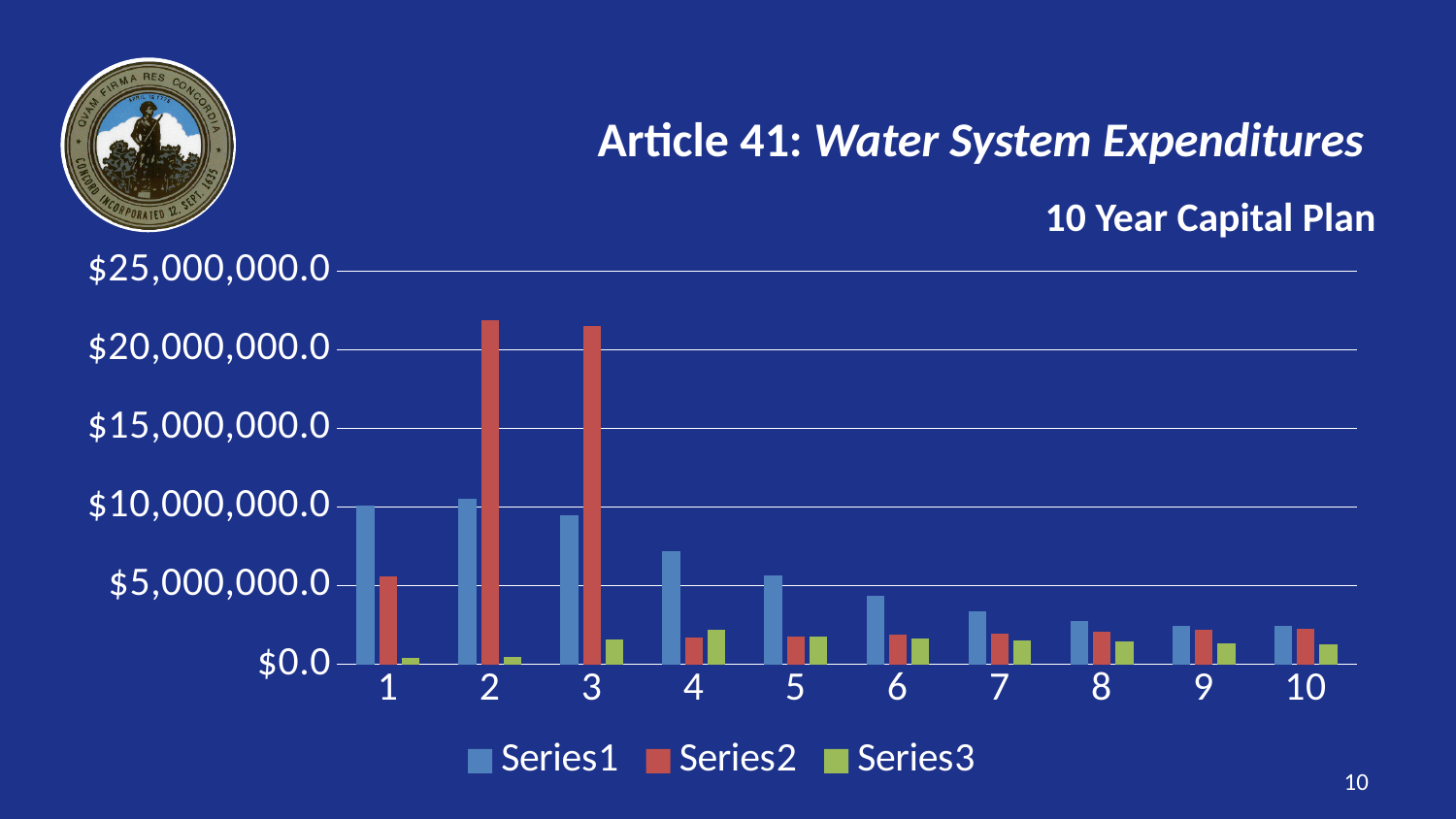
For category 2, which series has the larger value, Series1 or Series2? Series2 How many series does the legend list? 3 Is the Series2 value for category 2 greater or less than $20,000,000.0? greater What is the subtitle shown above the chart? 10 Year Capital Plan What kind of chart is shown on the slide? Bar chart Do the Series1 values generally rise or fall from category 1 to category 10? Fall Which category has the highest Series3 value? 4 Is the Series3 value for category 4 greater or less than $5,000,000.0? less For category 1, which series has the larger value, Series1 or Series2? Series1 How many categories are shown along the x axis? 10 Is the Series1 value for category 6 greater or less than $5,000,000.0? less